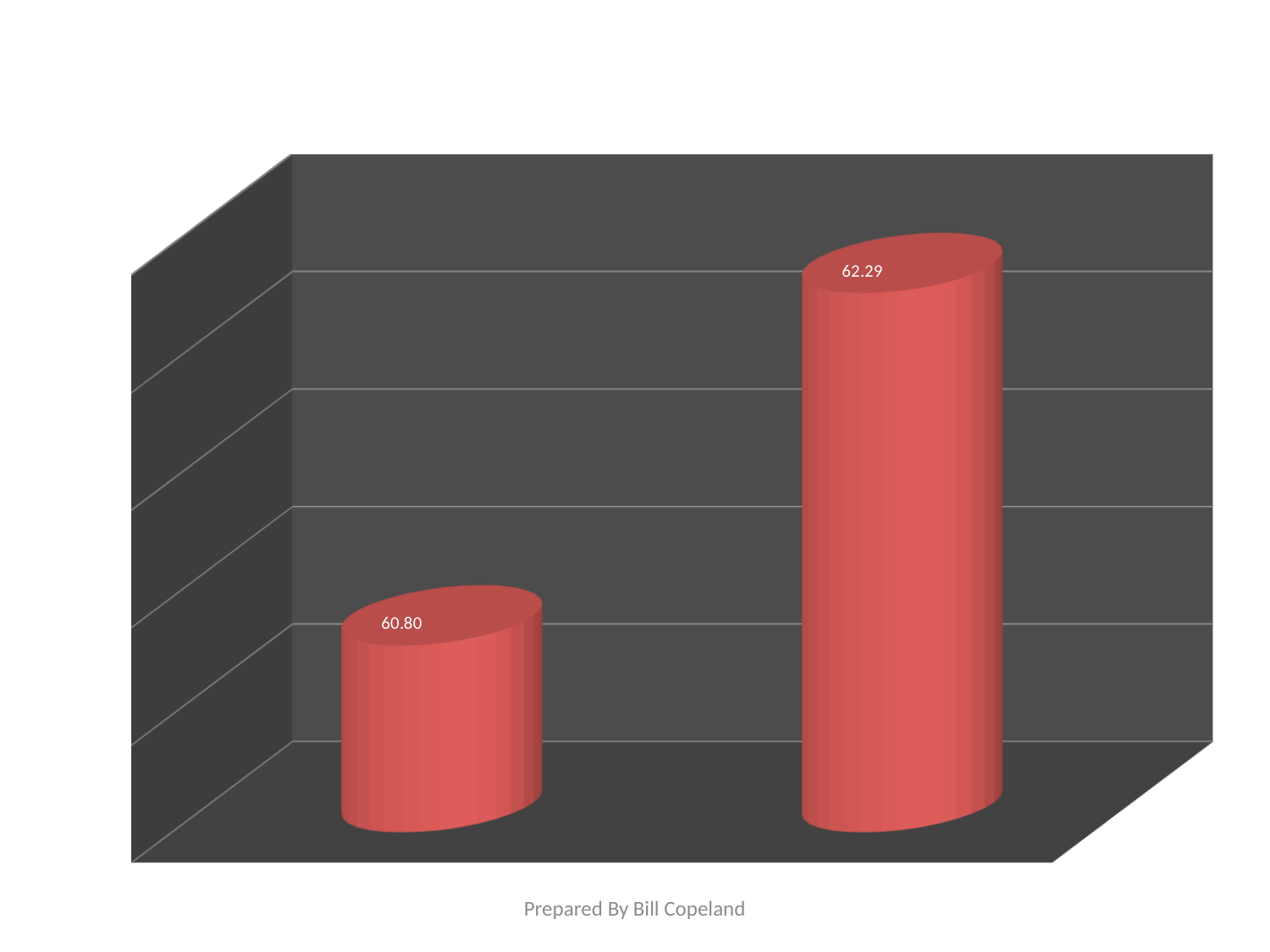
What colour are the bars on the chart? red How many bars are plotted on the chart? 2 What is the value shown on the right bar? 62.29 What text appears below the chart? Prepared By Bill Copeland Which bar has the lower value, the left or the right? the left bar What kind of chart is shown on the slide? bar chart What is the difference between the right bar's value and the left bar's value? 1.49 Which bar has the higher value, the left or the right? the right bar Is the value of the left bar larger or smaller than the value of the right bar? smaller Do the values rise or fall from the left bar to the right bar? rise What is the value shown on the left bar? 60.80